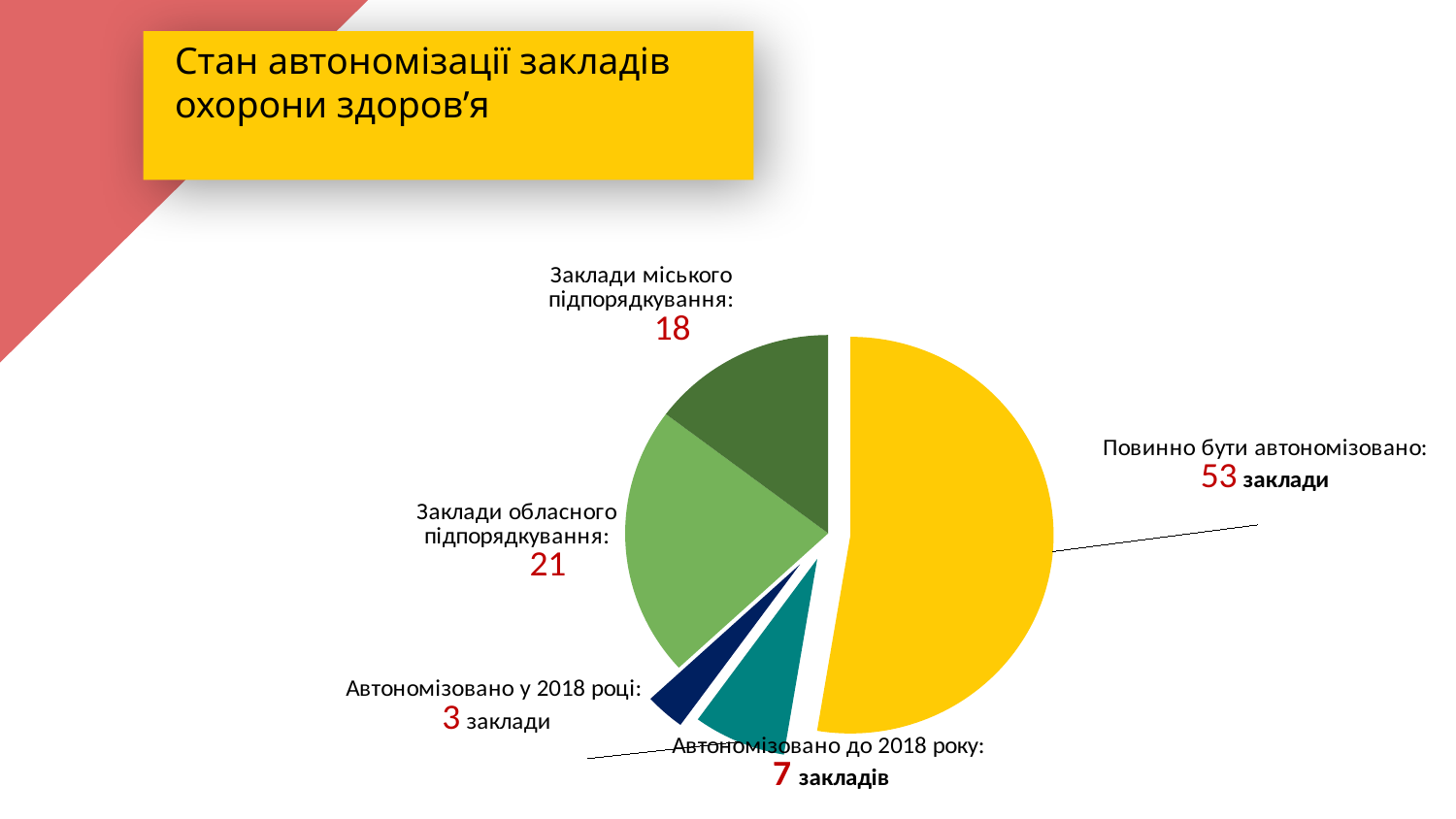
What is the value for "Автономізовано до 2018 року"? 7 What is the value for "Заклади обласного підпорядкування"? 21 Which category has the smallest slice of the pie? Автономізовано у 2018 році What is the title of the slide? Стан автономізації закладів охорони здоров’я What kind of chart is shown on the slide? pie chart How many slices does the pie chart have? 5 What is the difference between the values for "Заклади обласного підпорядкування" and "Заклади міського підпорядкування"? 3 What is the value for "Повинно бути автономізовано"? 53 What is the value for "Заклади міського підпорядкування"? 18 Which category has the largest slice of the pie? Повинно бути автономізовано What is the value for "Автономізовано у 2018 році"? 3 Which is larger: "Автономізовано до 2018 року" or "Автономізовано у 2018 році"? Автономізовано до 2018 року